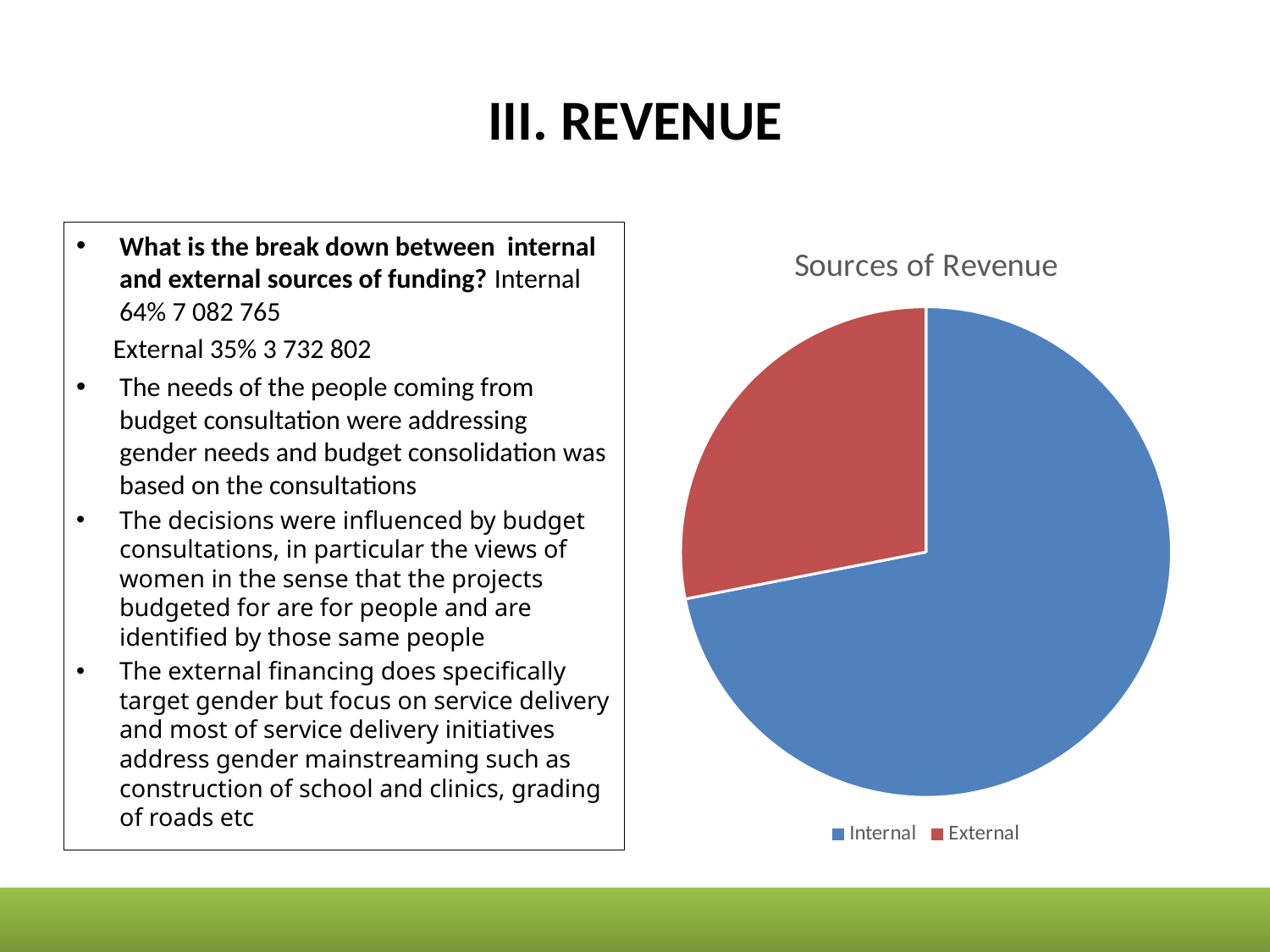
How many slices does the pie chart have? 2 Does the External slice take up more or less than half of the pie? less Does the Internal slice take up more or less than half of the pie? more What is the title of the chart? Sources of Revenue Which slice is larger, Internal or External? Internal Which source of revenue has the largest slice of the pie? Internal What colour is the Internal slice in the pie chart? blue How many entries does the chart legend list? 2 Which source of revenue has the smallest slice of the pie? External What kind of chart is shown on the slide? pie chart